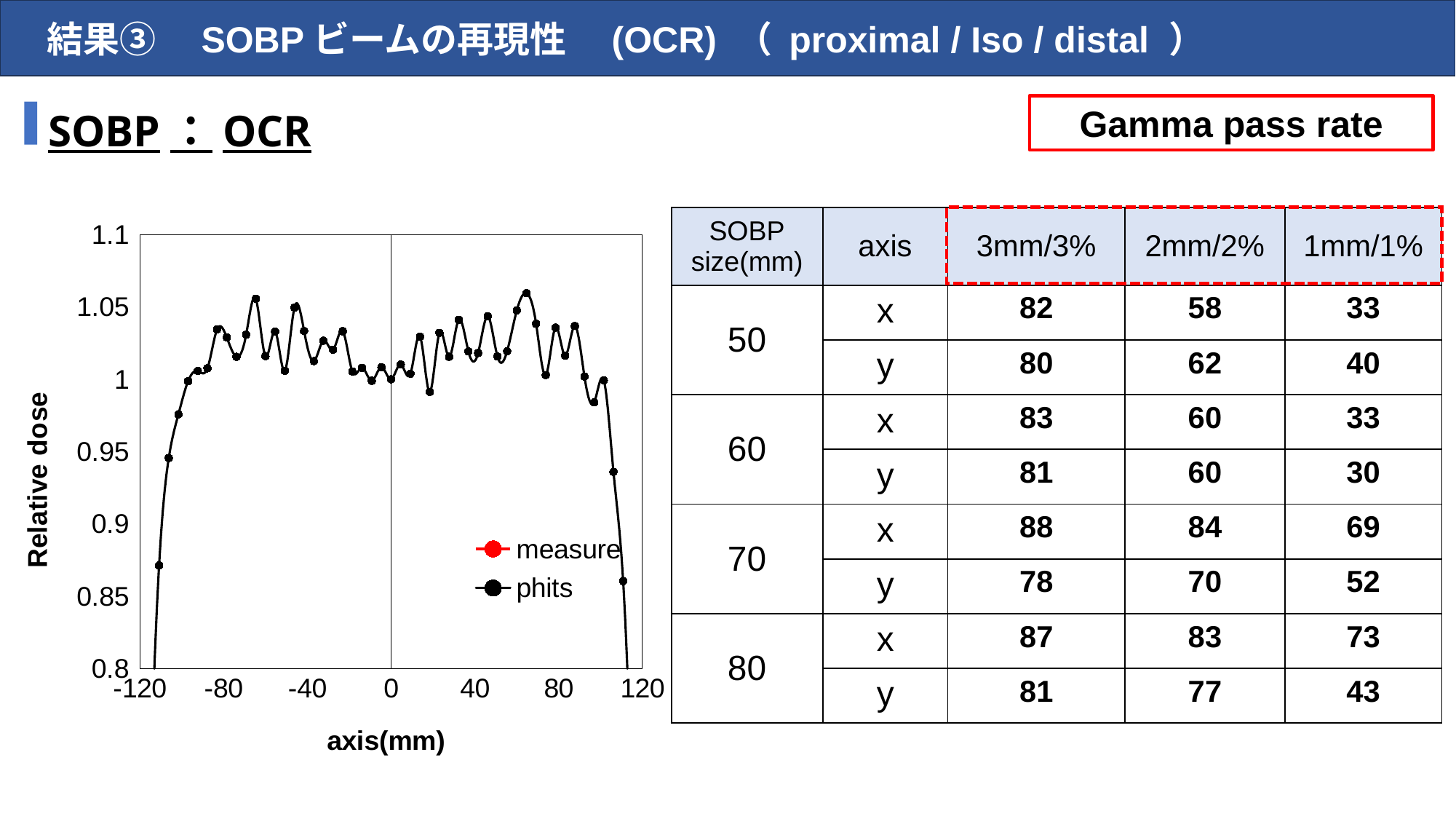
Is the phits value at the leftmost plotted point (near -110 mm) greater or less than 0.9? less Do the phits values rise or fall as the axis goes from -120 mm to -80 mm? rise How many series does the chart legend list? 2 Do the phits values rise or fall as the axis goes from 80 mm to 120 mm? fall Is the phits value at axis 0 mm greater or less than 0.95? greater What is the label of the chart's vertical axis? Relative dose Is the highest phits value on the chart greater or less than 1.1? less What are the two series named in the chart legend? measure and phits Which of the two values is larger: the phits value at -80 mm or at -110 mm? -80 mm What kind of chart is shown on the slide? line chart